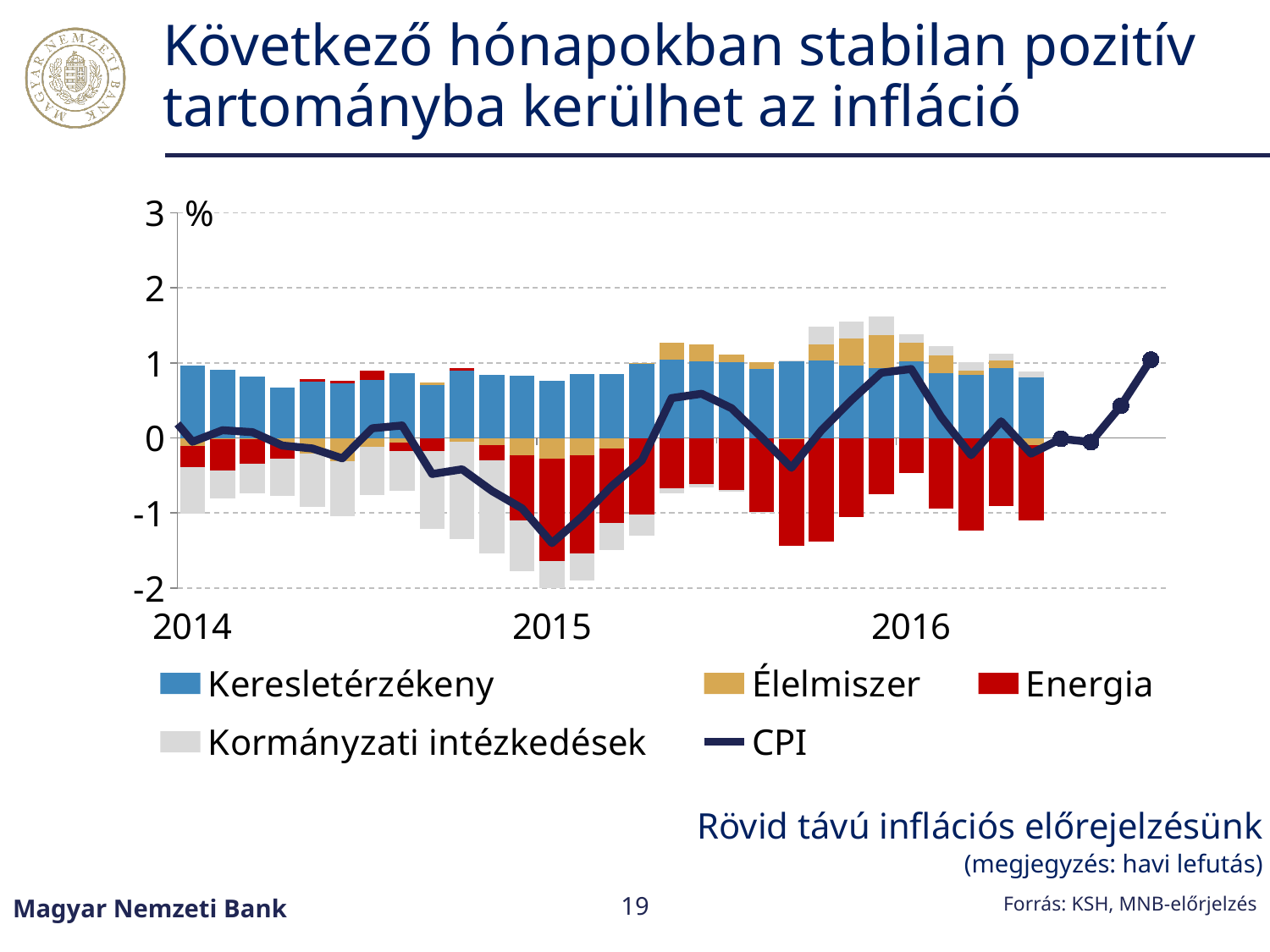
Is the CPI value at the start of 2016 greater or less than 0? greater What unit is shown on the vertical axis? % Does the CPI line rise or fall overall from the start of 2015 to the end of the series? rise Which series is drawn as a line rather than as bars? CPI Is the last CPI value on the chart greater or less than 0? greater How many of the legend entries are bar series (as opposed to the line)? 4 How many series does the legend list? 5 Is the CPI value at the start of 2015 greater or less than -1? less What kind of chart is shown on the slide? A stacked bar chart combined with a line In which year does the CPI line reach its lowest point? 2015 Which series is shown in red? Energia Does the CPI line rise or fall between the start of 2014 and the start of 2015? fall